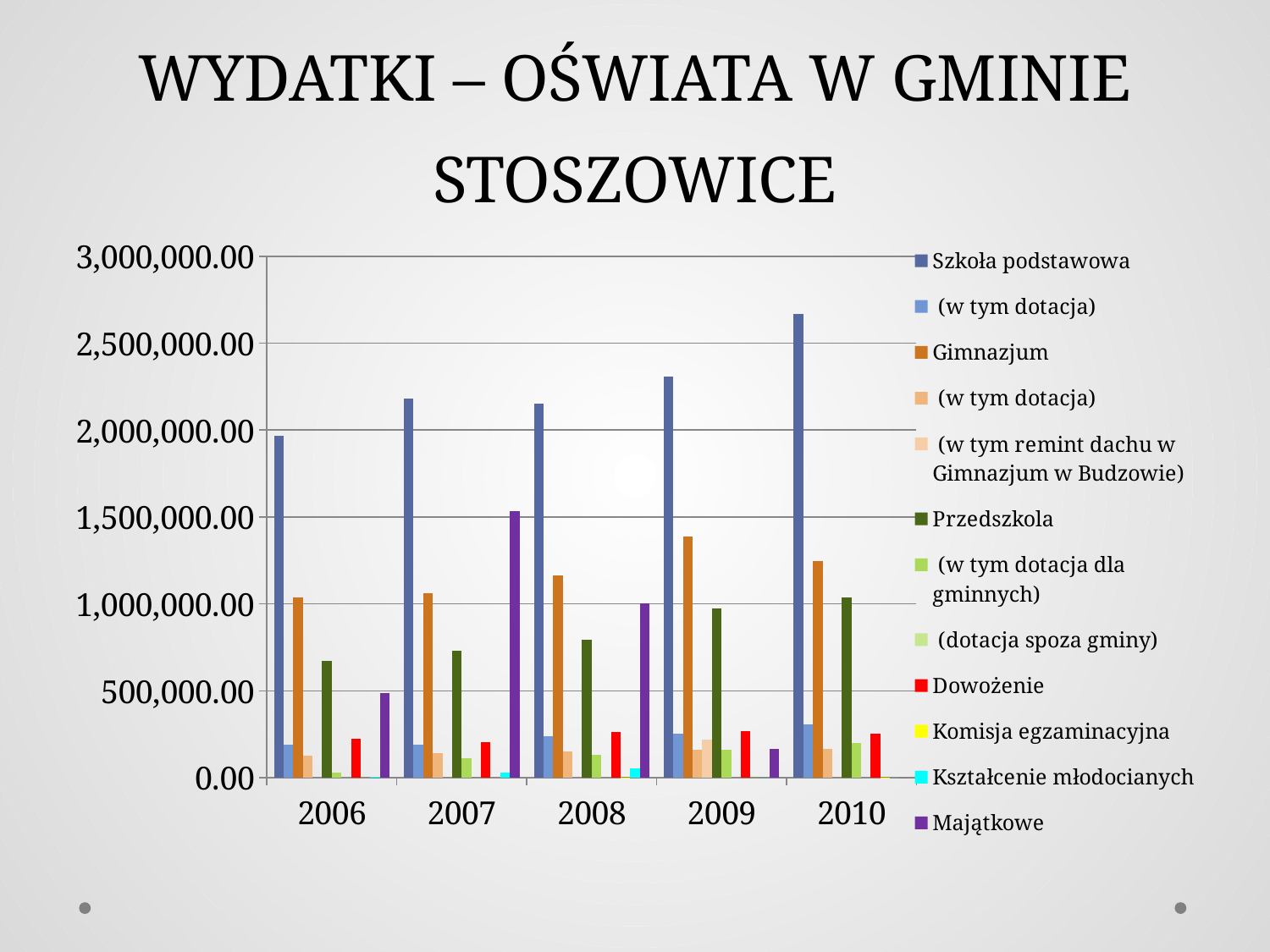
In which year is the value for Szkoła podstawowa lowest? 2006 Which is larger in 2007: Majątkowe or Przedszkola? Majątkowe In which year is the value for Szkoła podstawowa highest? 2010 Do the values for Przedszkola rise or fall from 2006 to 2010? rise What kind of chart is shown on the slide? bar chart Is the value for Gimnazjum in 2009 greater or less than 1,500,000.00? less Is the value for Przedszkola in 2008 greater or less than 500,000.00? greater In which year is the value for Majątkowe highest? 2007 Is the value for Szkoła podstawowa in 2010 greater or less than 2,500,000.00? greater In which year is the value for Gimnazjum highest? 2009 How many series does the chart's legend list? 12 How many years are shown on the x axis of the chart? 5